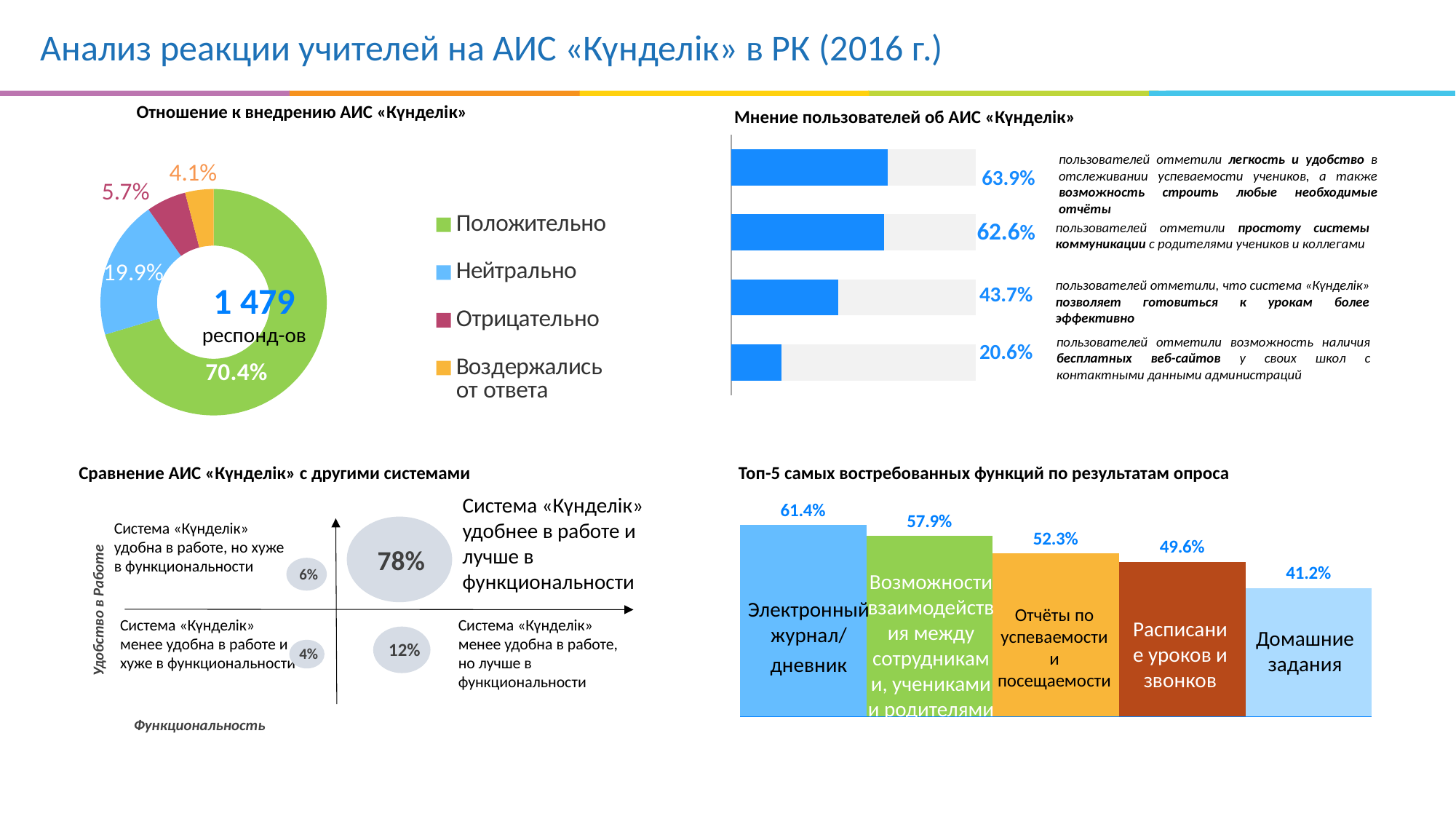
In the chart titled «Отношение к внедрению АИС «Күнделік»», what percentage of respondents answered «Положительно»? 70.4% In the chart titled «Мнение пользователей об АИС «Күнделік»», how many bars are plotted? 4 In the chart titled «Отношение к внедрению АИС «Күнделік»», what share is shown for «Нейтрально»? 19.9% In the chart titled «Отношение к внедрению АИС «Күнделік»», how many categories does the legend list? 4 In the chart titled «Топ-5 самых востребованных функций по результатам опроса», what is the value for «Домашние задания»? 41.2% In the chart titled «Сравнение АИС «Күнделік» с другими системами», what percentage is shown in the largest bubble? 78% In the chart titled «Мнение пользователей об АИС «Күнделік»», what is the highest value shown? 63.9% In the chart titled «Отношение к внедрению АИС «Күнделік»», what is the difference between the «Отрицательно» and «Воздержались от ответа» shares? 1.6% In the chart titled «Отношение к внедрению АИС «Күнделік»», which category has the smallest share? Воздержались от ответа In the chart titled «Топ-5 самых востребованных функций по результатам опроса», what is the difference between «Отчёты по успеваемости и посещаемости» and «Расписание уроков и звонков»? 2.7% In the chart titled «Топ-5 самых востребованных функций по результатам опроса», which function has the highest value? Электронный журнал/дневник What number of respondents is shown in the centre of the donut chart titled «Отношение к внедрению АИС «Күнделік»»? 1 479